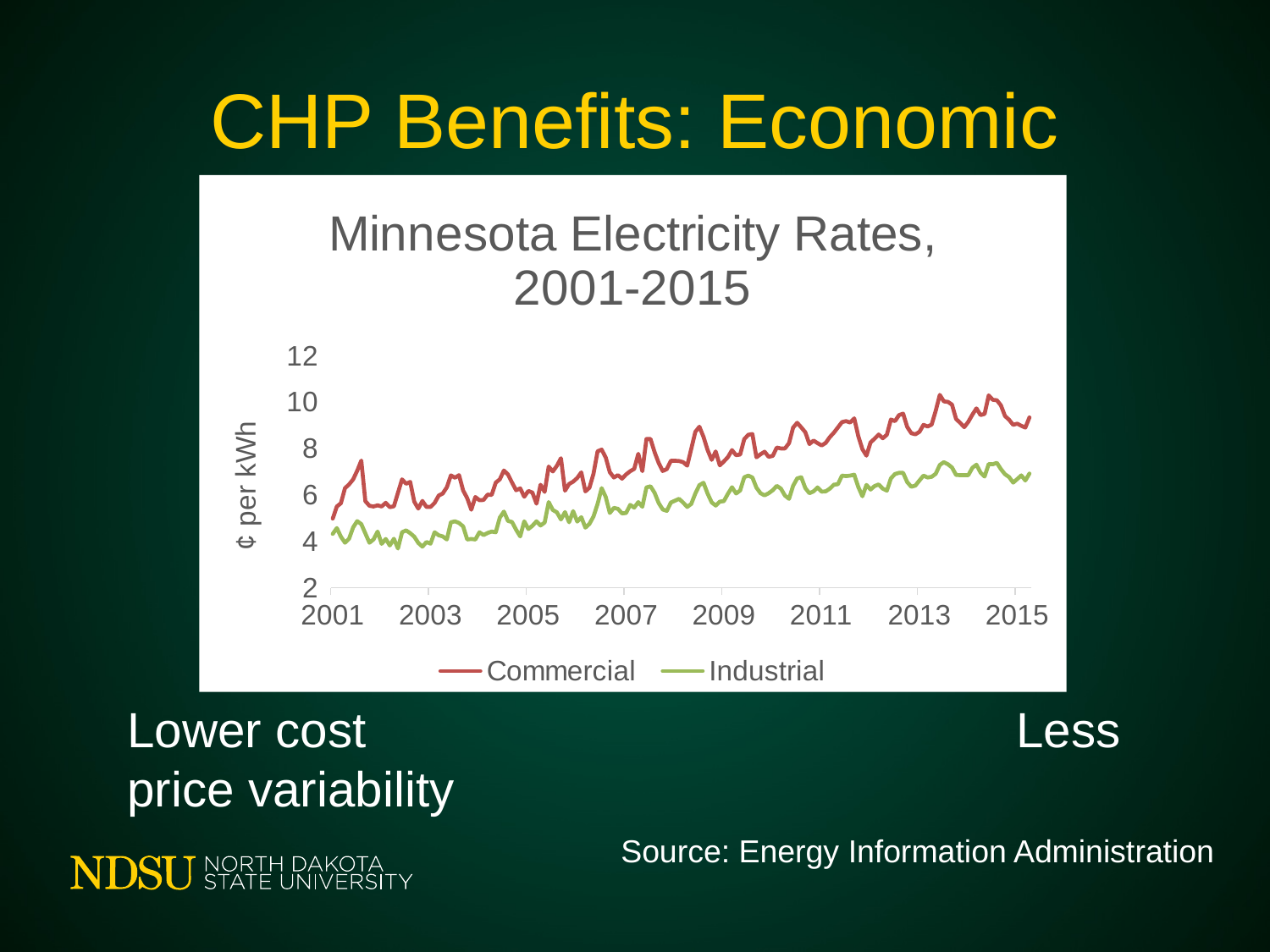
What is the label on the vertical axis? ¢ per kWh Which series has higher values throughout the chart, Commercial or Industrial? Commercial Do the Commercial rates generally rise or fall from 2001 to 2015? rise Is the Commercial value at the start of 2001 greater or less than 6? less Is the Industrial value at the end of the series in 2015 greater or less than 8? less How many series does the legend list? 2 How many year labels are shown on the x axis? 8 What kind of chart is shown on the slide? line chart Is the Commercial value at the end of the series in 2015 greater or less than 8? greater What is the title of the chart? Minnesota Electricity Rates, 2001-2015 Do the Industrial rates generally rise or fall from 2001 to 2015? rise